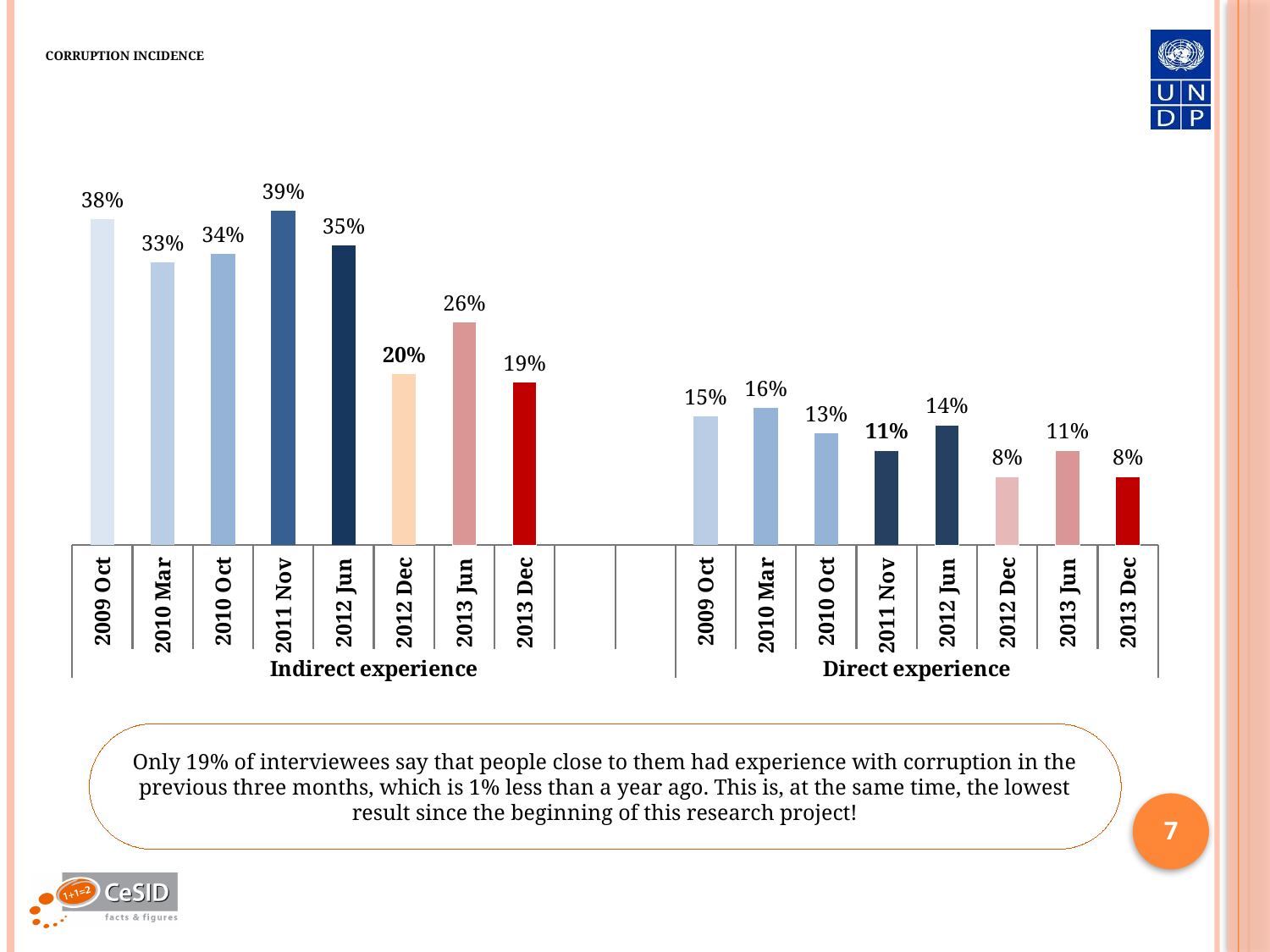
What is the value for 2012 Jun under Direct experience? 14% What is the value for 2011 Nov under Indirect experience? 39% What is the value for 2013 Dec under Direct experience? 8% Which time point has the lowest value in the Indirect experience group? 2013 Dec What are the two groups labelled on the x axis of the chart? Indirect experience and Direct experience What is the difference between the Indirect experience values for 2012 Dec and 2013 Dec? 1% What kind of chart is shown on the slide? Bar chart How many time points are shown in the Direct experience group? 8 What is the difference between the Indirect experience and Direct experience values for 2009 Oct? 23% Which is larger: the Direct experience value for 2010 Oct or for 2012 Jun? 2012 Jun Which time point has the highest value in the Direct experience group? 2010 Mar Which time point has the highest value in the Indirect experience group? 2011 Nov